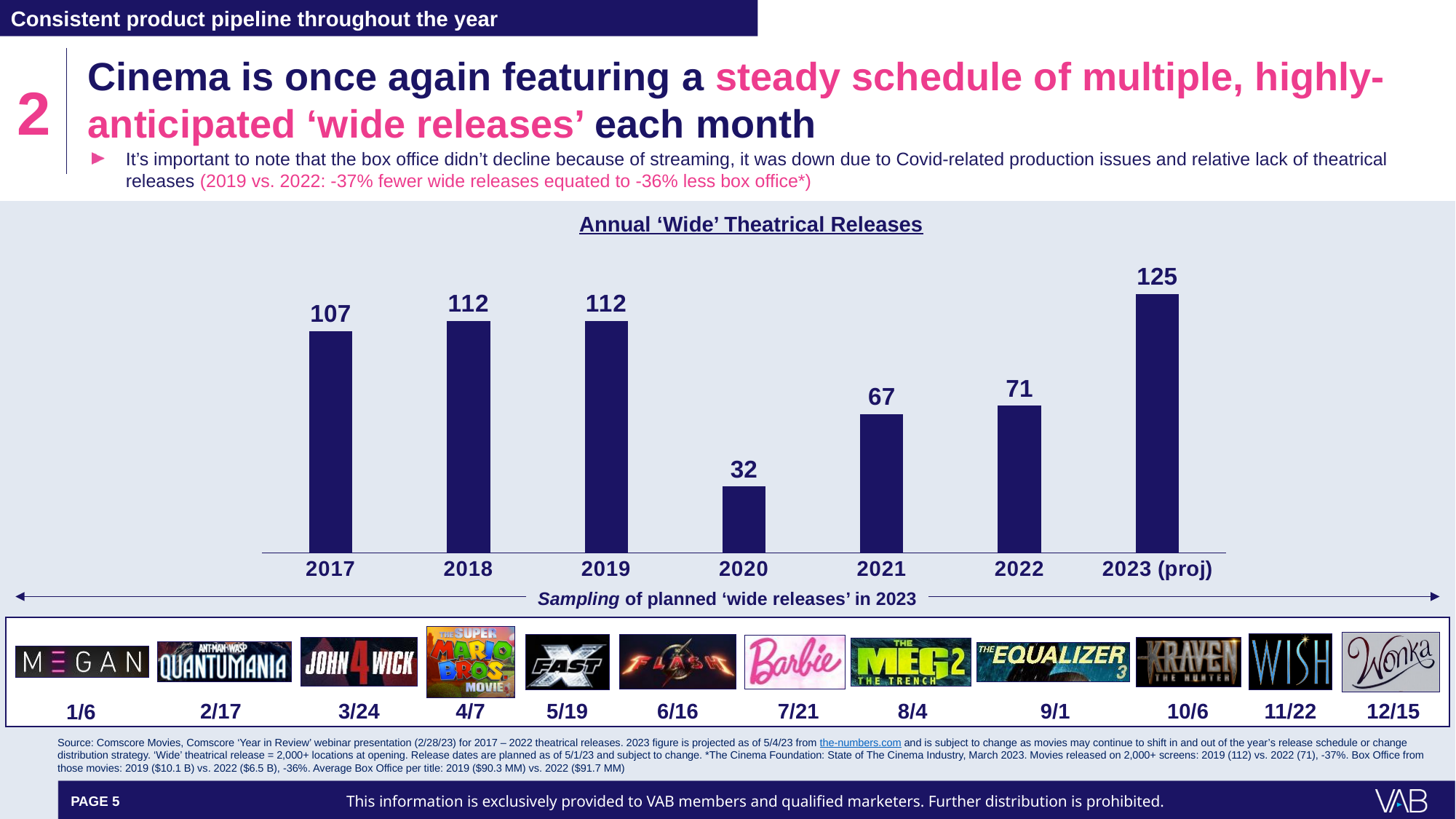
What kind of chart is used to show Annual 'Wide' Theatrical Releases? Bar chart What is the number of annual 'wide' theatrical releases shown for 2017? 107 What is the value shown for 2020 in the Annual 'Wide' Theatrical Releases chart? 32 Which is larger, the value for 2021 or the value for 2022? 2022 Which year has the highest number of wide theatrical releases in the chart? 2023 (proj) Which year has the lowest number of wide theatrical releases in the chart? 2020 What is the projected number of wide theatrical releases for 2023? 125 How many years (bars) are shown in the Annual 'Wide' Theatrical Releases chart? 7 What is the difference between the 2023 (proj) value and the 2022 value? 54 Do the values rise or fall from 2019 to 2020 in the chart? Fall What is the difference between the 2019 and 2022 values in the chart? 41 What is the title of the chart on the slide? Annual 'Wide' Theatrical Releases